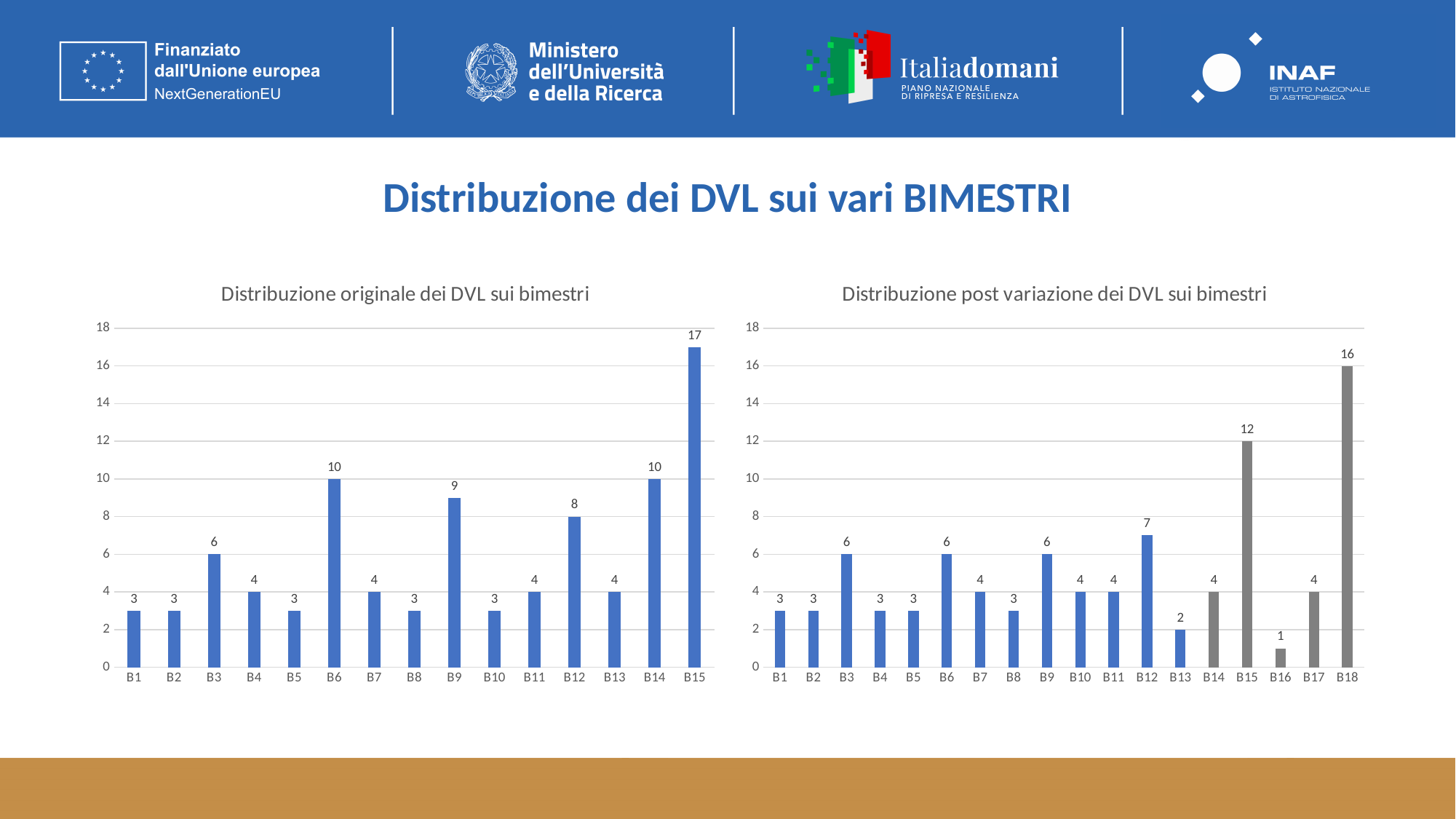
In the chart 'Distribuzione post variazione dei DVL sui bimestri', what is the value for B13? 2 In the chart 'Distribuzione originale dei DVL sui bimestri', what is the difference between the values for B6 and B9? 1 In the chart 'Distribuzione originale dei DVL sui bimestri', what is the value for B15? 17 In the chart 'Distribuzione post variazione dei DVL sui bimestri', what colour are the bars for B14 to B18? Grey In the chart 'Distribuzione post variazione dei DVL sui bimestri', what is the difference between the values for B18 and B15? 4 In the chart 'Distribuzione post variazione dei DVL sui bimestri', how many bimestri are shown on the x axis? 18 What kind of chart is 'Distribuzione originale dei DVL sui bimestri'? Bar chart In the chart 'Distribuzione originale dei DVL sui bimestri', how many bimestri are shown on the x axis? 15 In the chart 'Distribuzione post variazione dei DVL sui bimestri', which bimestre has the lowest value? B16 In the chart 'Distribuzione post variazione dei DVL sui bimestri', what is the value for B18? 16 In the chart 'Distribuzione originale dei DVL sui bimestri', which bimestre has the highest value? B15 In the chart 'Distribuzione post variazione dei DVL sui bimestri', which is larger, the value for B15 or the value for B12? B15